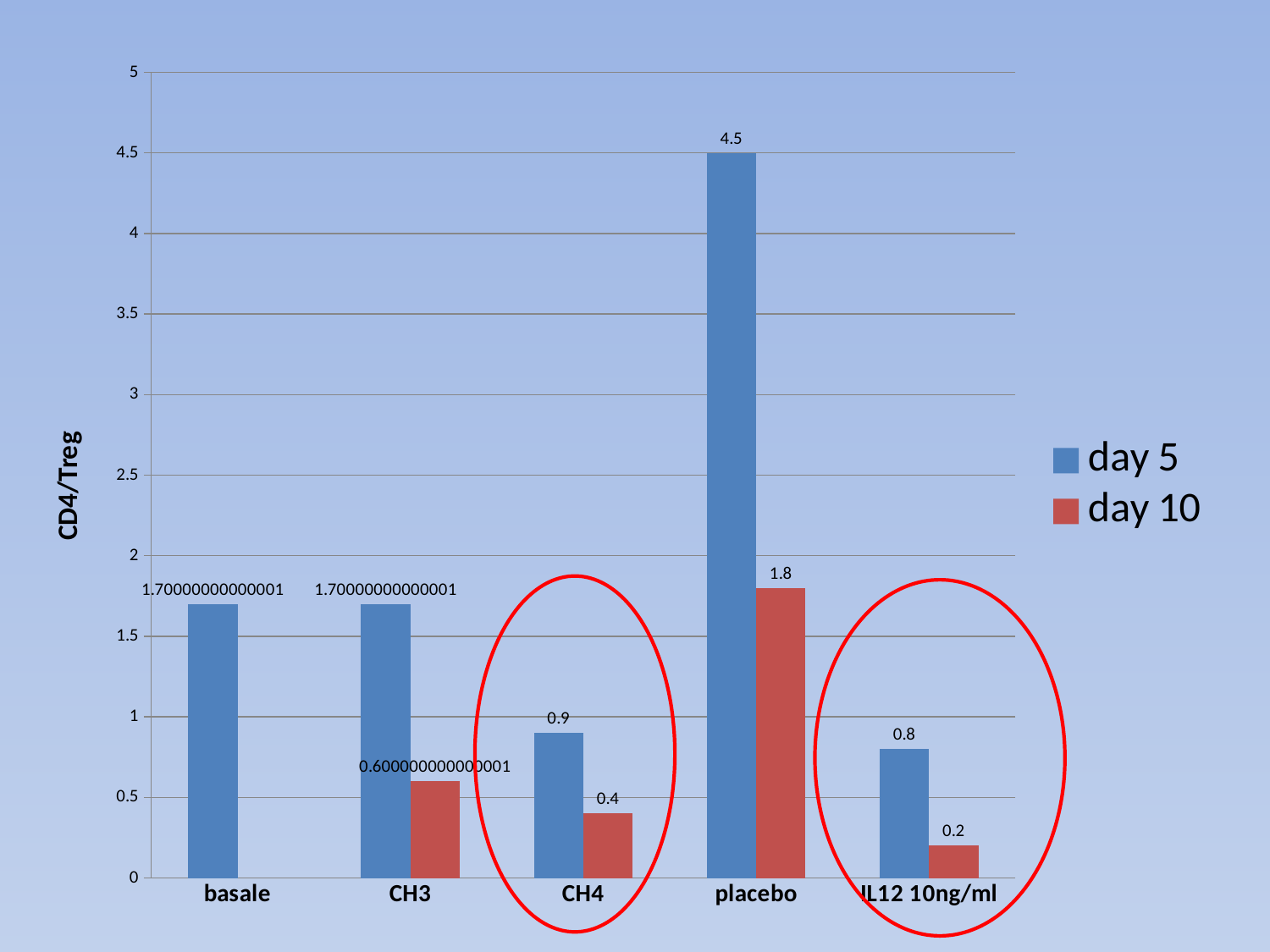
What is the difference between the day 5 and day 10 values for placebo? 2.7 How many series does the legend list? 2 Which category has the highest day 5 value? placebo What is the day 10 value for placebo? 1.8 Which is larger, the day 5 value for CH4 or the day 5 value for IL12 10ng/ml? CH4 What is the day 10 value for CH4? 0.4 What is the label on the vertical axis? CD4/Treg How many categories are shown on the x axis? 5 What is the day 5 value for IL12 10ng/ml? 0.8 Which category has the lowest day 10 value? IL12 10ng/ml What type of chart is shown on the slide? bar chart What is the day 5 value for placebo? 4.5